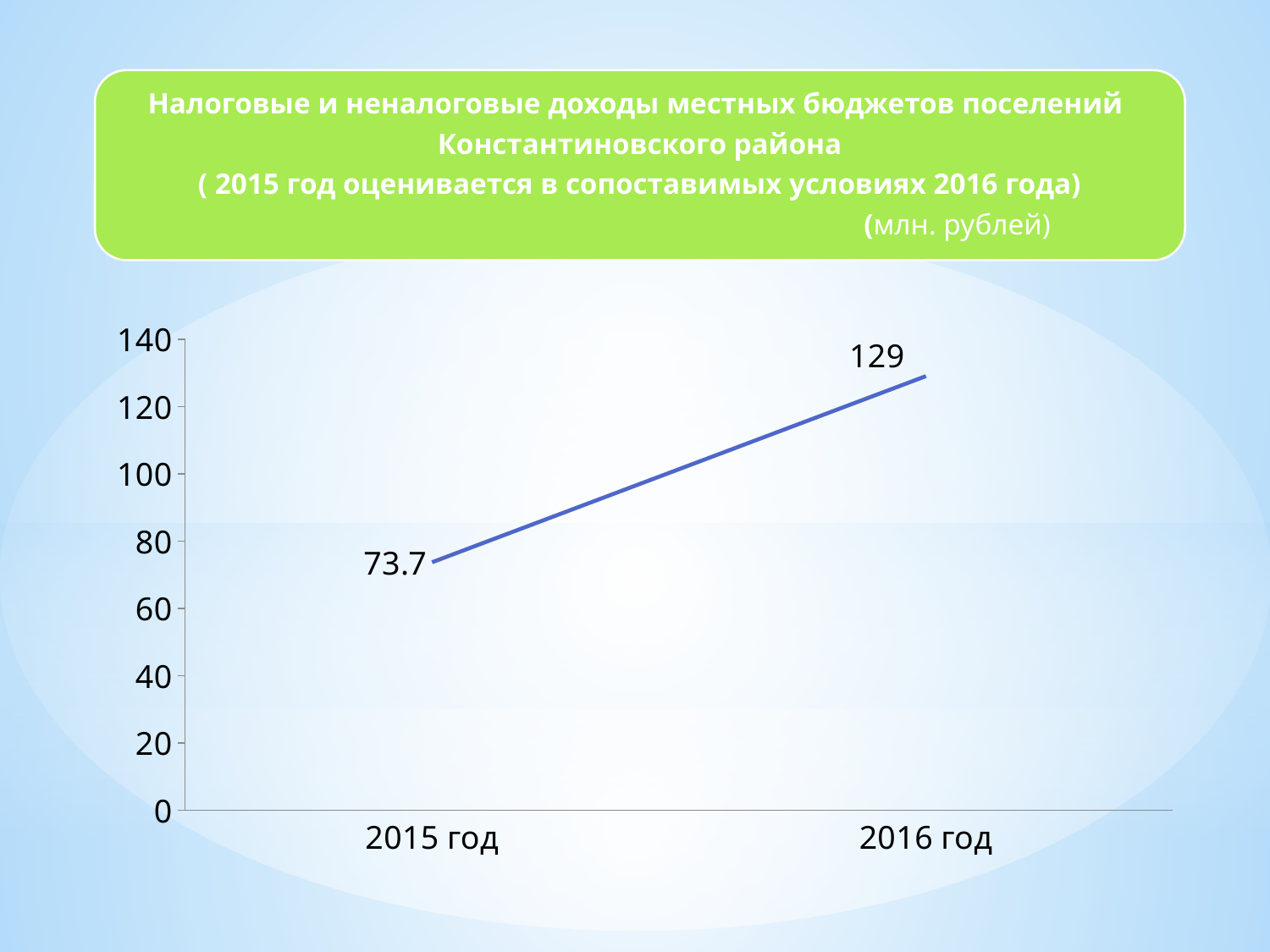
Do the values rise or fall from 2015 год to 2016 год? rise What unit of measurement is stated in the chart title? млн. рублей Is the value for 2016 год greater or less than 120? greater Is the value for 2016 год larger or smaller than the value for 2015 год? larger Is the value for 2015 год greater or less than 80? less What is the value for 2015 год? 73.7 Which year has the lower value? 2015 год How many data points are plotted on the chart? 2 What is the value for 2016 год? 129 What is the difference between the values for 2016 год and 2015 год? 55.3 Which year has the higher value? 2016 год What kind of chart is shown on the slide? line chart